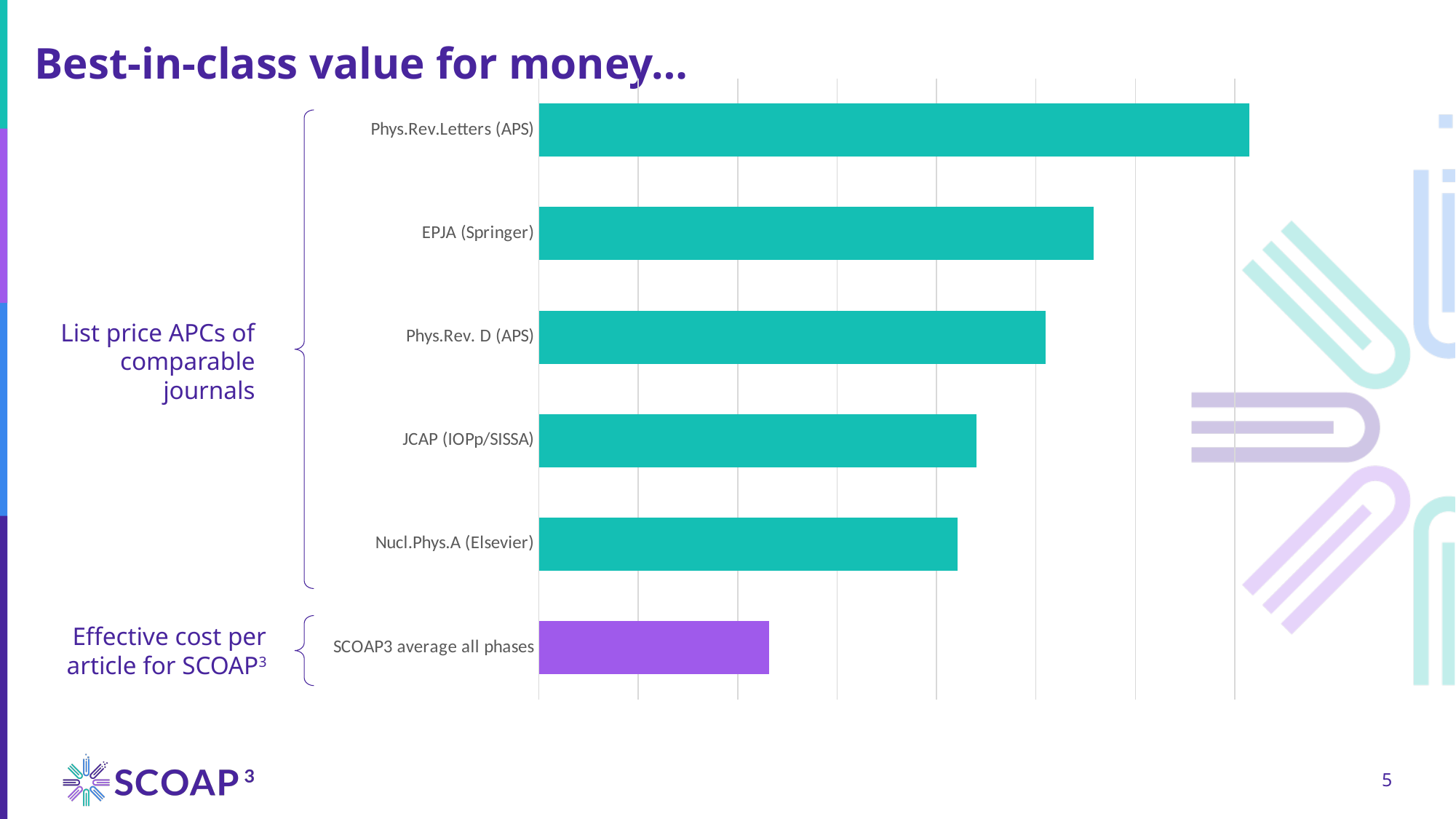
Which of the comparable journals has the lowest list price APC in the chart? Nucl.Phys.A (Elsevier) Which bar is longer, EPJA (Springer) or Phys.Rev. D (APS)? EPJA (Springer) What is the title of the slide containing the chart? Best-in-class value for money… What colour is the bar for SCOAP3 average all phases? purple What kind of chart is shown on the slide? bar chart Which category has the shortest bar in the chart? SCOAP3 average all phases How many bars does the chart show? 6 Do the bar lengths increase or decrease going from the top bar to the bottom bar? decrease Which bar is longer, Nucl.Phys.A (Elsevier) or SCOAP3 average all phases? Nucl.Phys.A (Elsevier) Which bar is longer, Phys.Rev. D (APS) or JCAP (IOPp/SISSA)? Phys.Rev. D (APS) Which category has the longest bar in the chart? Phys.Rev.Letters (APS)